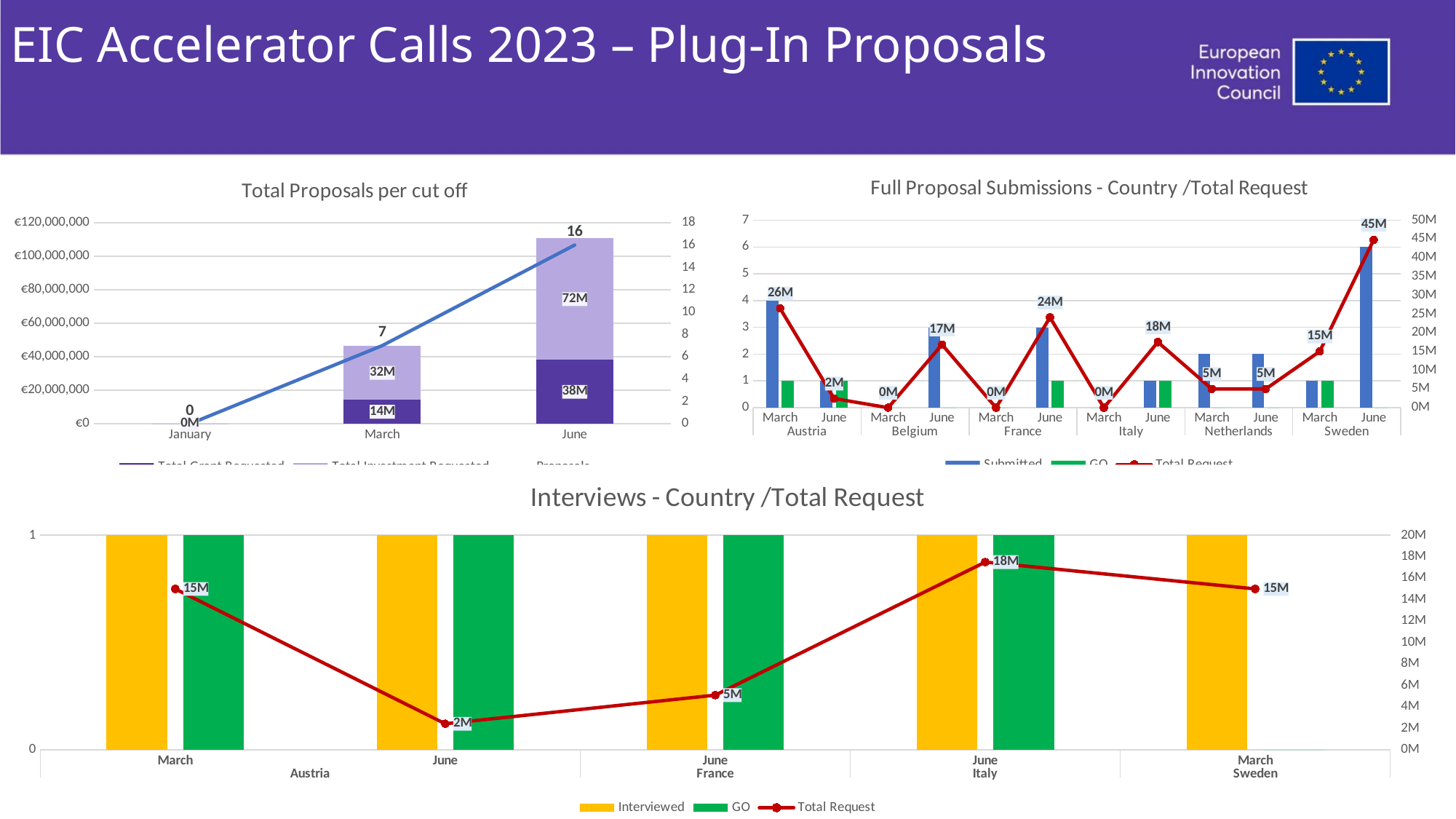
In the 'Total Proposals per cut off' chart, how many more proposals were there in June than in March? 9 In the 'Full Proposal Submissions - Country /Total Request' chart, what is the Total Request for France in June? 24M In the 'Total Proposals per cut off' chart, how many proposals are shown for June? 16 In the 'Total Proposals per cut off' chart, what is the combined total of the June stacked bar (grant plus investment)? 110M How many series does the legend of the 'Interviews - Country /Total Request' chart list? 3 In the 'Interviews - Country /Total Request' chart, what is the Total Request for Italy in June? 18M How many country/month categories are shown on the x axis of the 'Interviews - Country /Total Request' chart? 5 In the 'Full Proposal Submissions - Country /Total Request' chart, which has more Submitted proposals: Austria March or Sweden June? Sweden June In the 'Total Proposals per cut off' chart, does the Proposals line rise or fall from January to June? rise In the 'Interviews - Country /Total Request' chart, which country and month has the lowest Total Request? Austria June In the 'Total Proposals per cut off' chart, what is the Total Investment Requested for March? 32M In the 'Full Proposal Submissions - Country /Total Request' chart, which country and month has the highest Total Request? Sweden June